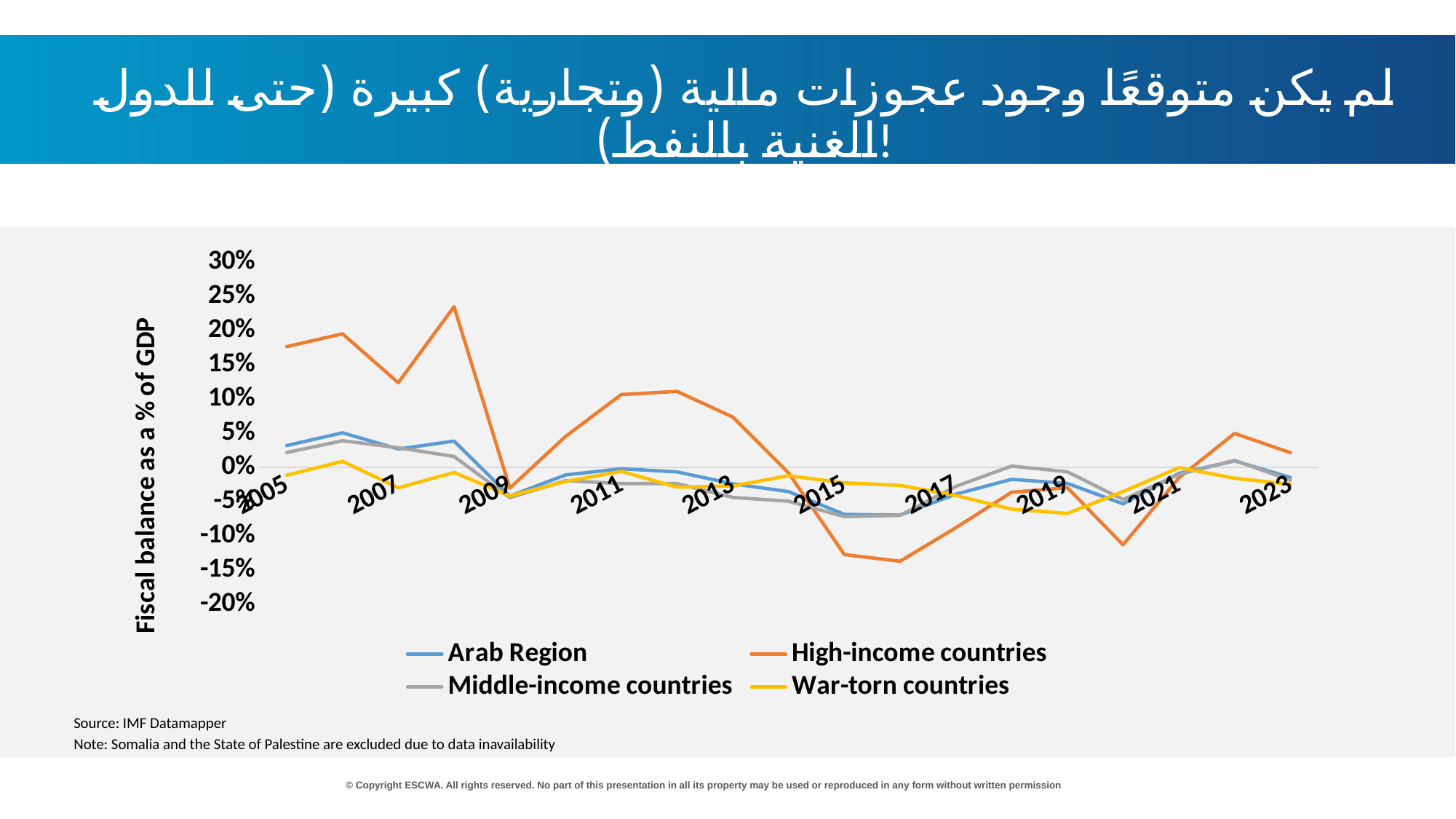
What is the title of the vertical axis? Fiscal balance as a % of GDP What are the four series listed in the legend? Arab Region, High-income countries, Middle-income countries, War-torn countries How many year labels are shown on the x axis? 10 Which series reaches the lowest value anywhere on the chart? High-income countries Is the value for High-income countries in 2008 greater or less than 20%? greater How many series does the legend list? 4 Is the value for High-income countries in 2005 greater or less than 15%? greater Is the value for High-income countries in 2016 greater or less than -10%? less Between 2008 and 2009, does the High-income countries line rise or fall? fall What kind of chart is shown on the slide? line chart In 2005, which series has the higher value, High-income countries or Arab Region? High-income countries In 2020, which series has the lower value, High-income countries or Arab Region? High-income countries